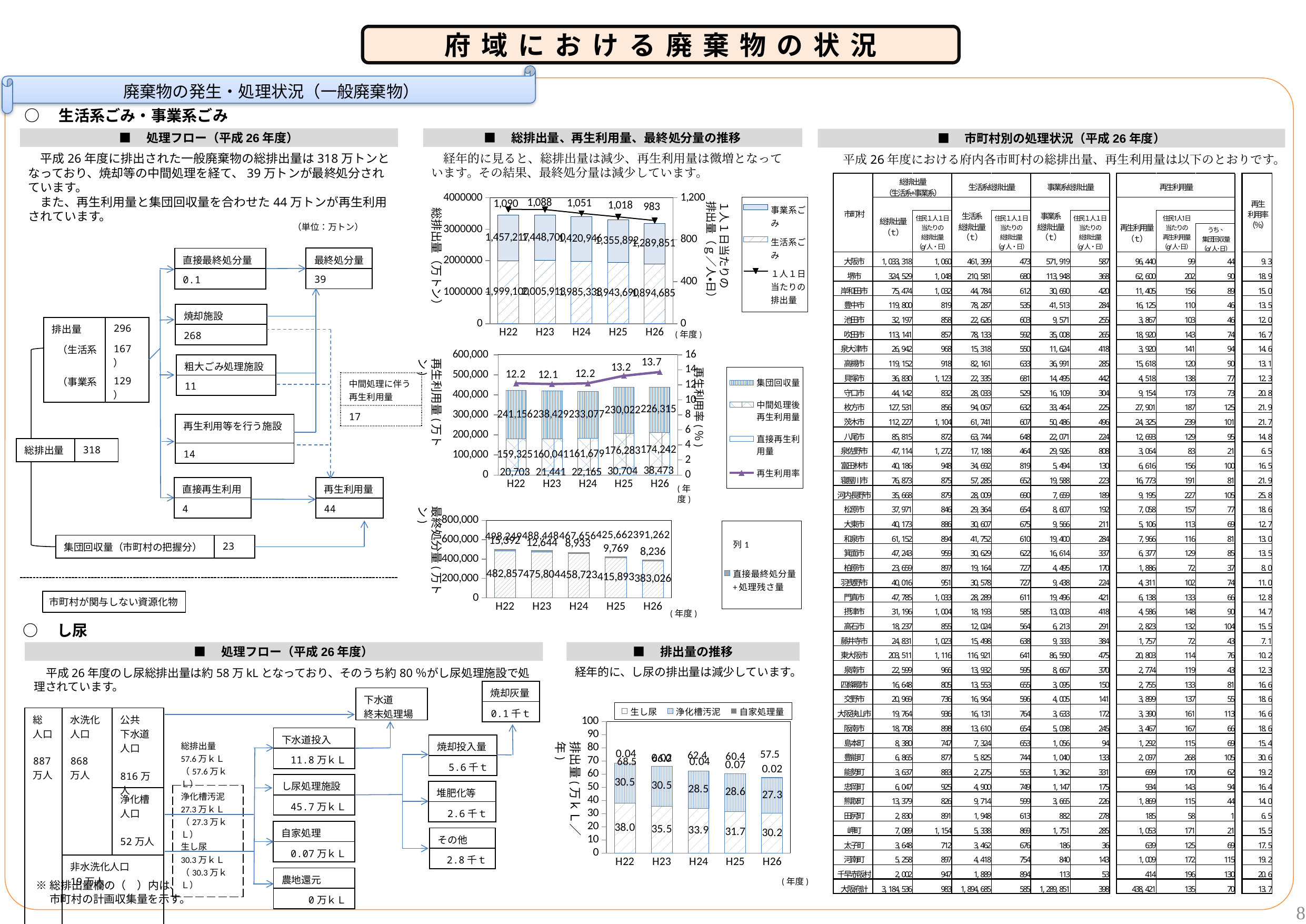
In the middle chart of 総排出量、再生利用量、最終処分量の推移 (再生利用量), how many years are shown on the x axis? 5 In the し尿 排出量の推移 chart (bottom middle), what is the difference between the 生し尿 values for H22 and H26? 7.8 In the し尿 排出量の推移 chart (bottom middle), how many series does the legend list? 3 In the middle chart of 総排出量、再生利用量、最終処分量の推移 (再生利用量), what is the 集団回収量 value for H22? 241,156 In the し尿 排出量の推移 chart (bottom middle), which year has the lowest 生し尿 value? H26 In the し尿 排出量の推移 chart (bottom middle), does the 生し尿 value rise or fall from H22 to H26? fall In the top chart of 総排出量、再生利用量、最終処分量の推移, which year has the highest 1人1日当たりの排出量? H22 In the し尿 排出量の推移 chart (bottom middle), what is the value of 浄化槽汚泥 for H26? 27.3 In the し尿 排出量の推移 chart (bottom middle), what is the value of 生し尿 for H22? 38.0 In the middle chart of 総排出量、再生利用量、最終処分量の推移 (再生利用量), what is the 再生利用率 for H26? 13.7 In the top chart of 総排出量、再生利用量、最終処分量の推移, what is the 生活系ごみ value for H23? 2,005,913 In the top chart of 総排出量、再生利用量、最終処分量の推移, what is the 1人1日当たりの排出量 value for H26? 983